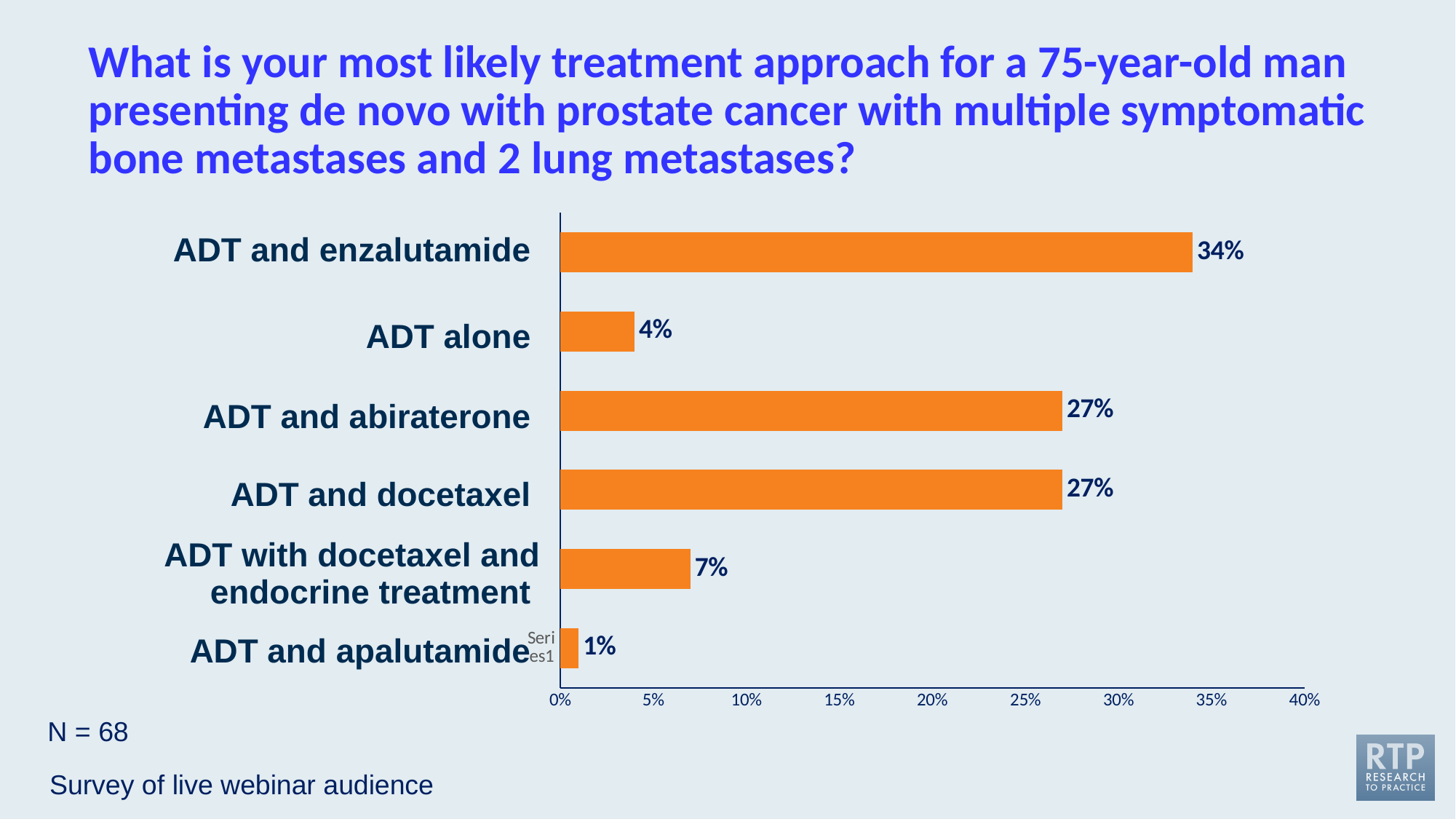
How many treatment approaches are shown in the chart? 6 Which treatment approach received the lowest percentage of responses? ADT and apalutamide What percentage of respondents chose ADT and apalutamide? 1% What percentage of respondents chose ADT alone? 4% What is the difference in percentage points between ADT and enzalutamide and ADT and abiraterone? 7 Which received a larger share of responses: ADT alone or ADT with docetaxel and endocrine treatment? ADT with docetaxel and endocrine treatment Which treatment approach received the highest percentage of responses? ADT and enzalutamide Is the value for ADT and docetaxel greater or less than 25%? greater What percentage of respondents chose ADT and enzalutamide? 34% What percentage of respondents chose ADT with docetaxel and endocrine treatment? 7% What is the sample size (N) stated on the slide? 68 What kind of chart is shown on the slide? Bar chart